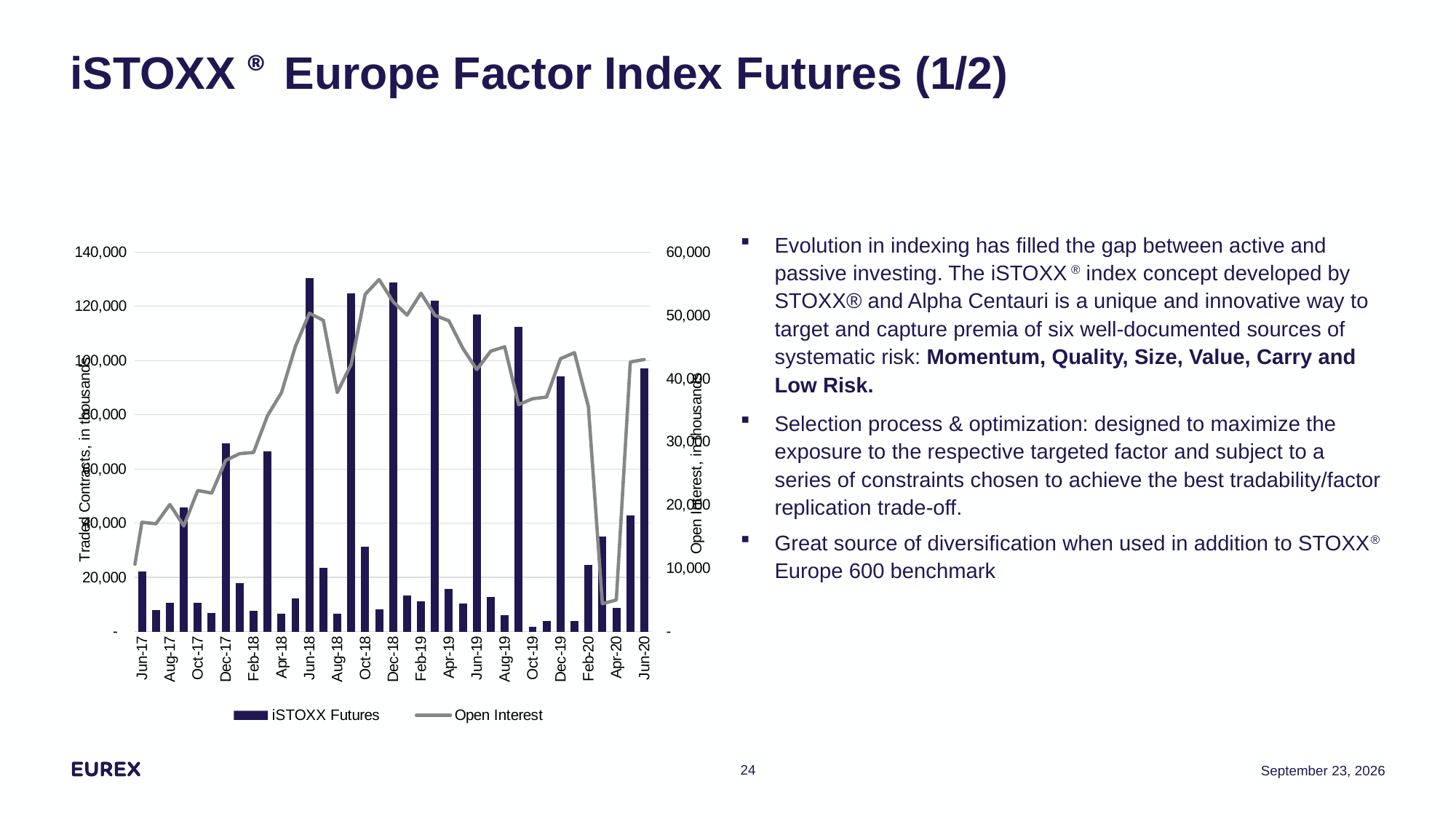
Is the iSTOXX Futures value for Jun-20 greater or less than 80,000? greater How many series does the chart legend list? 2 Is the iSTOXX Futures value for Jun-18 greater or less than 120,000? greater Is the iSTOXX Futures value for Dec-17 greater or less than 60,000? greater Which is larger, the iSTOXX Futures bar for Jun-18 or for Jun-17? Jun-18 Does the Open Interest line rise or fall between Jun-17 and Jun-18? rise What kind of chart is shown on the slide? A bar chart combined with a line chart Which month has the lowest iSTOXX Futures bar? Oct-19 What is the title of the left vertical axis of the chart? Traded Contracts, in thousands What are the two series named in the chart legend? iSTOXX Futures and Open Interest